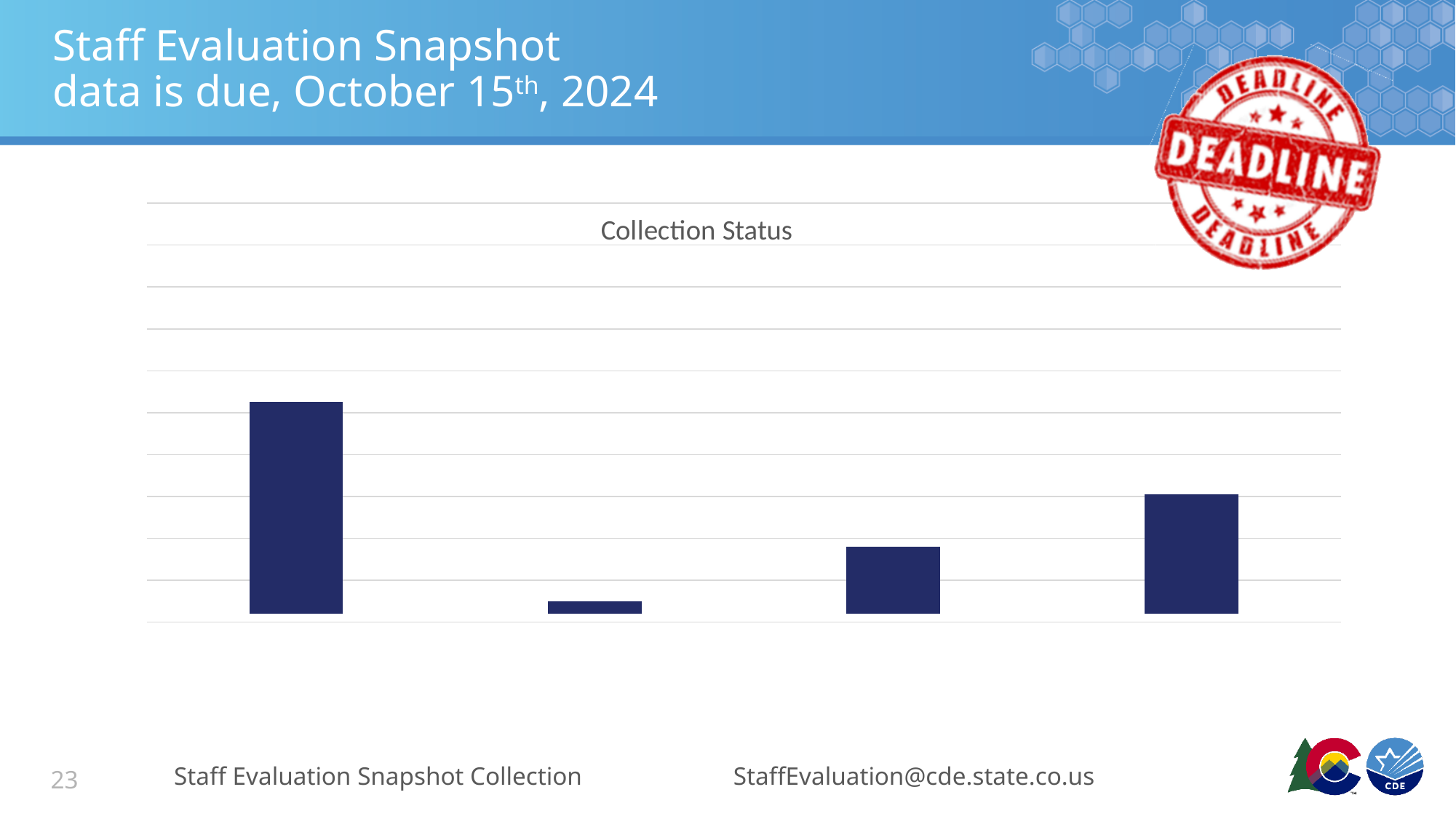
Which bar in the Collection Status chart is the tallest, counting from the left? the first (leftmost) bar What colour are the bars in the Collection Status chart? dark navy blue What kind of chart is shown under the title "Collection Status"? bar chart In the Collection Status chart, is the first bar or the fourth bar taller? the first bar Which bar in the Collection Status chart is the shortest, counting from the left? the second bar What is the title of the chart on the slide? Collection Status In the Collection Status chart, is the second bar or the third bar taller? the third bar In the Collection Status chart, is the third bar or the fourth bar taller? the fourth bar How many bars are plotted in the Collection Status chart? 4 Does the Collection Status chart display a legend? No